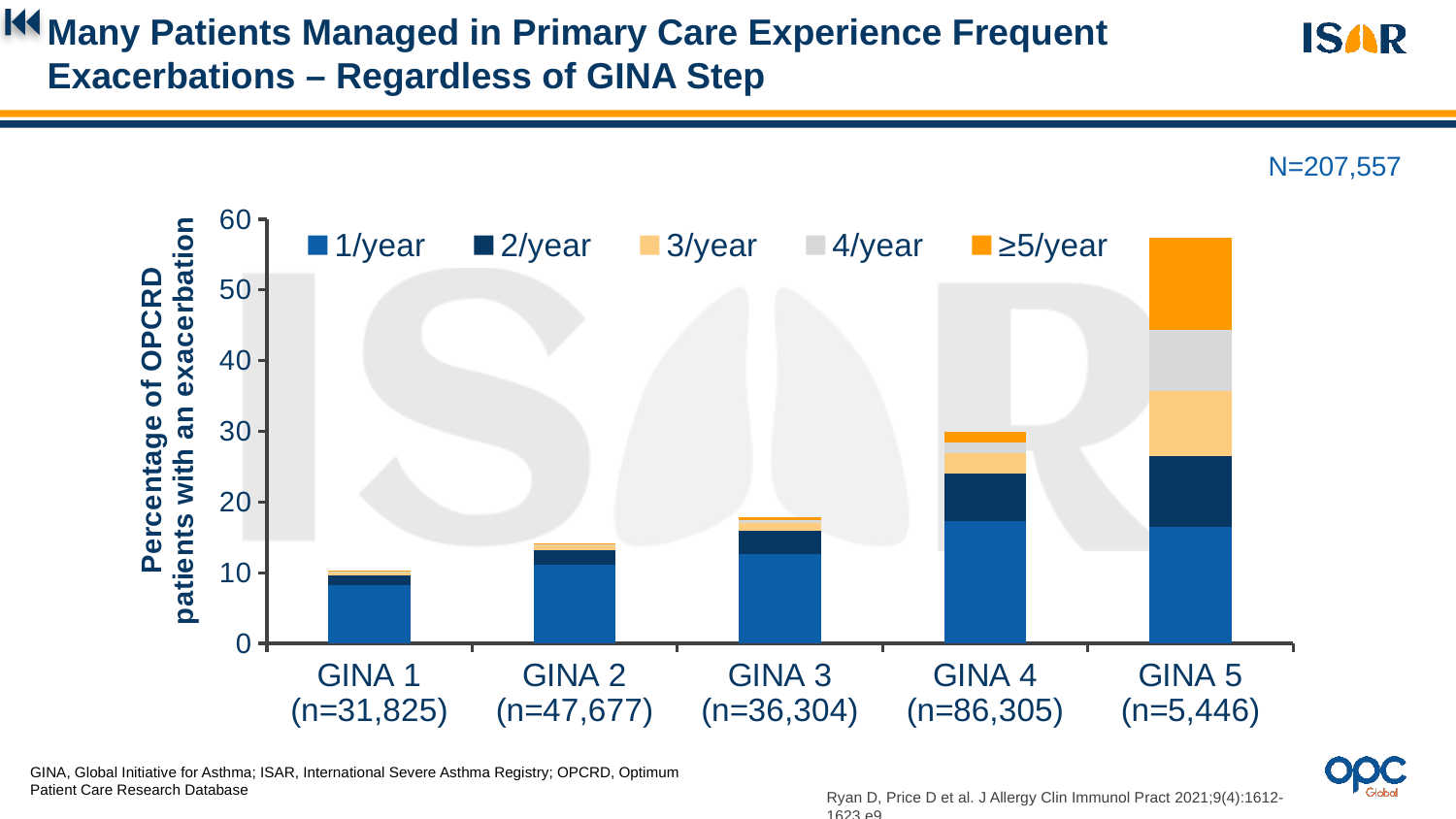
Is the total bar height for GINA 3 greater or less than 20? less What is the n value shown for GINA 4 on the x axis? n=86,305 What kind of chart is shown on the slide? Stacked bar chart Which GINA step has the highest total percentage of patients with an exacerbation? GINA 5 How many series does the legend list? 5 Which has a larger total bar, GINA 4 or GINA 5? GINA 5 Which GINA step has the lowest total percentage of patients with an exacerbation? GINA 1 Do the total bar heights rise or fall from GINA 1 to GINA 5? rise Is the total bar height for GINA 5 greater or less than 50? greater Is the total bar height for GINA 4 greater or less than 20? greater How many GINA step categories are shown on the x axis? 5 What is the sample size N stated above the chart? N=207,557